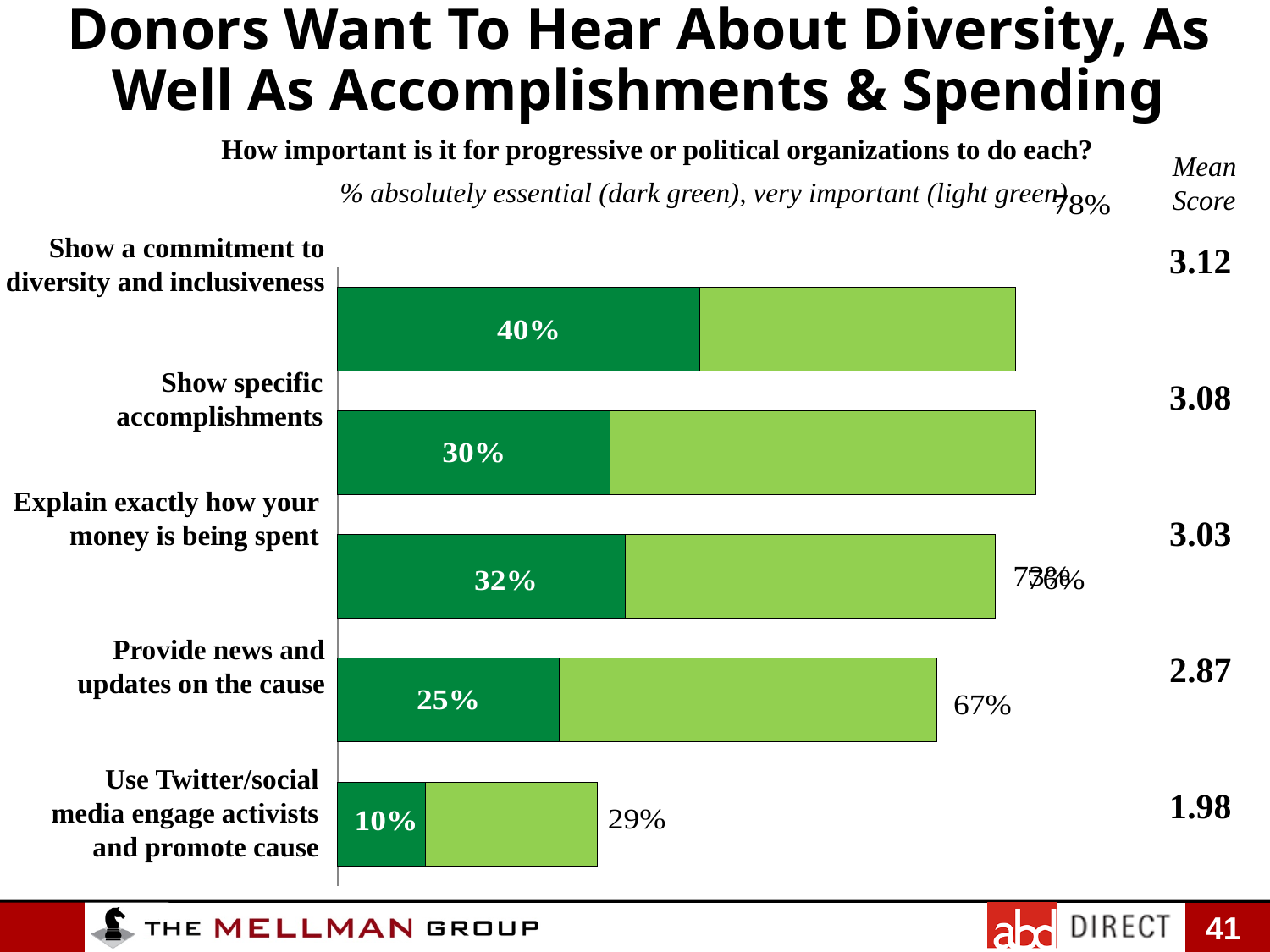
What is the absolutely essential (dark green) percentage for 'Use Twitter/social media engage activists and promote cause'? 10% Which item has the highest absolutely essential (dark green) percentage? Show a commitment to diversity and inclusiveness What percentage of donors say showing a commitment to diversity and inclusiveness is absolutely essential (dark green)? 40% Which has a larger absolutely essential (dark green) percentage: 'Show specific accomplishments' or 'Explain exactly how your money is being spent'? Explain exactly how your money is being spent What is the absolutely essential (dark green) percentage for 'Show specific accomplishments'? 30% Which item has the lowest absolutely essential (dark green) percentage? Use Twitter/social media engage activists and promote cause What is the absolutely essential (dark green) percentage for 'Explain exactly how your money is being spent'? 32% What kind of chart is shown on the slide? Stacked bar chart What is the combined absolutely essential plus very important percentage for 'Provide news and updates on the cause'? 67% What is the difference in percentage points between the absolutely essential share for 'Show a commitment to diversity and inclusiveness' and for 'Use Twitter/social media engage activists and promote cause'? 30 percentage points What is the absolutely essential (dark green) percentage for 'Provide news and updates on the cause'? 25% How many items are shown in the chart? 5